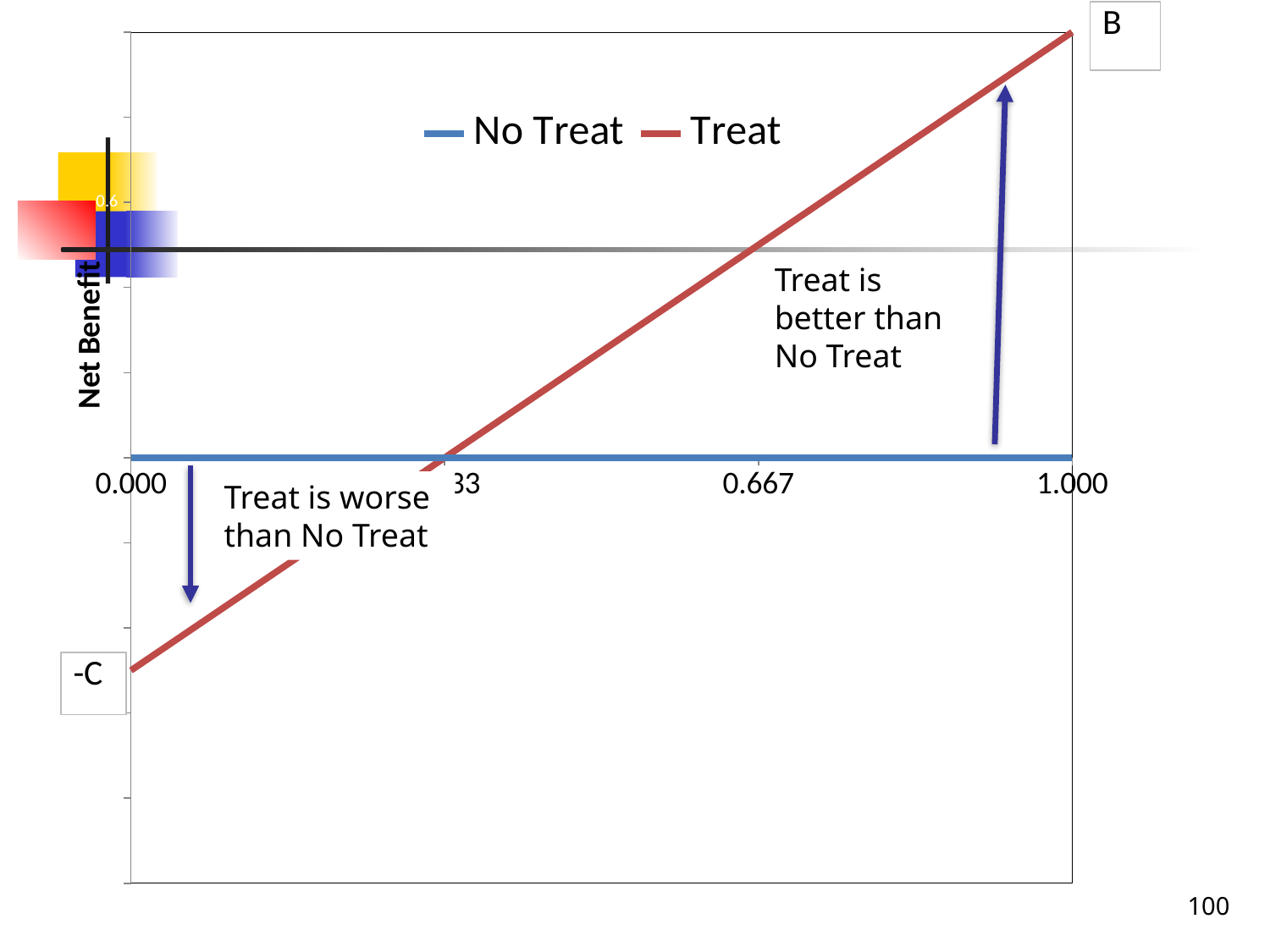
At x = 0.000, which series has the higher net benefit, Treat or No Treat? No Treat How many series does the legend list? 2 What is the largest value shown on the x axis? 1.000 What kind of chart is shown on the slide? line chart What are the two series named in the legend? No Treat and Treat What label marks the value of the Treat line at x = 0.000? -C Is the Treat line's value at x = 0.667 greater or less than the No Treat line's value? greater What is the label on the vertical axis? Net Benefit At x = 1.000, which series has the higher net benefit, Treat or No Treat? Treat Does the No Treat line rise, fall, or stay flat across the x axis? stay flat What label marks the value of the Treat line at x = 1.000? B Does the Treat line rise or fall as the x-axis value increases from 0.000 to 1.000? rise